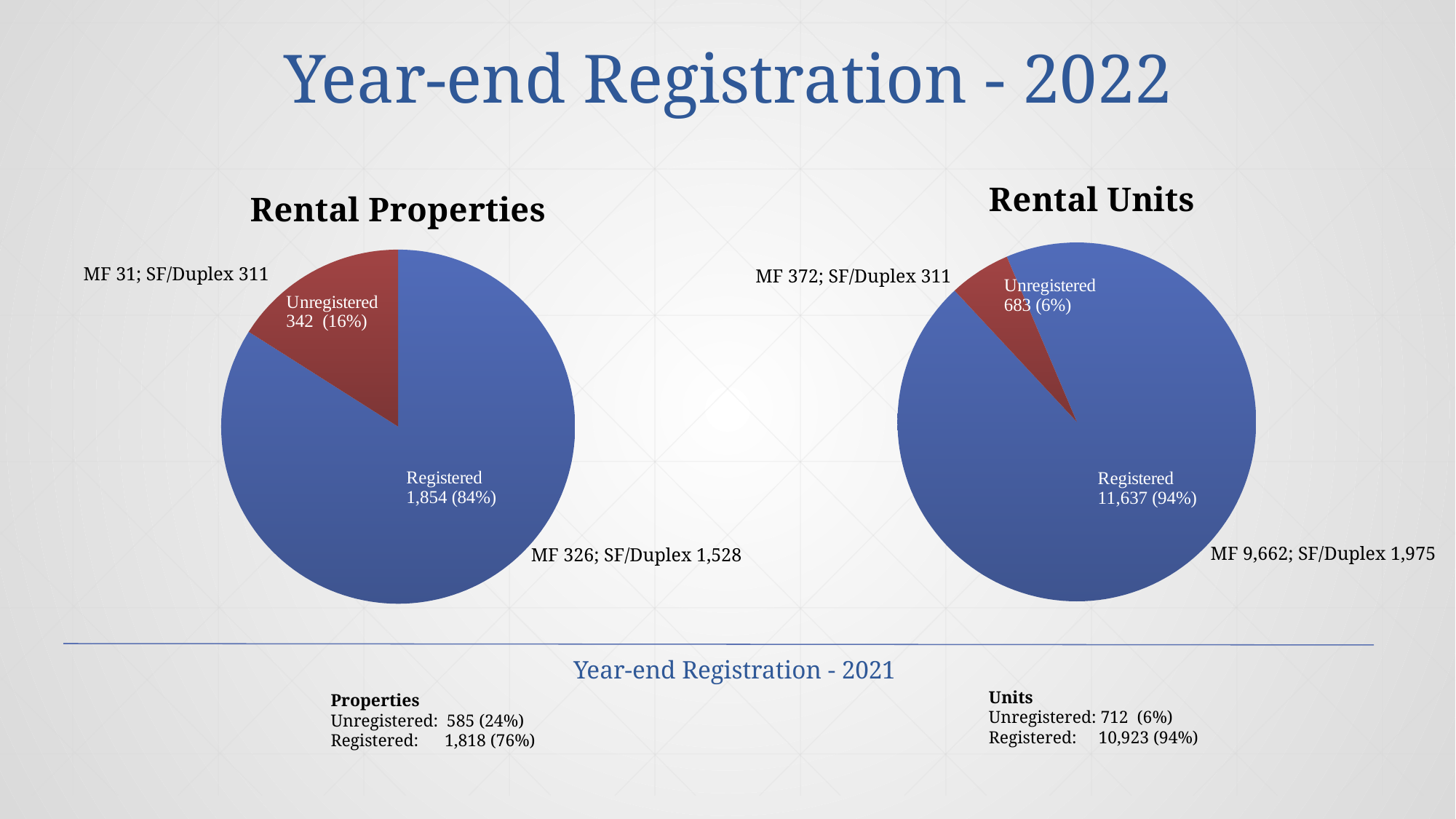
In the Rental Units chart, what is the difference between Registered and Unregistered units? 10,954 In the Rental Properties chart, how many properties are Registered? 1,854 What kind of chart is the Rental Units chart? Pie chart In the Rental Units chart, what share of the pie is Registered? 94% In the Rental Properties chart, how many properties are Unregistered? 342 In the Rental Units chart, how many units are Unregistered? 683 In the Rental Units chart, how many units are Registered? 11,637 In the Rental Properties chart, what share of the pie is Unregistered? 16% In the Rental Units chart, which slice is the smallest? Unregistered In the Rental Properties chart, which slice is the largest? Registered In the Rental Properties chart, what is the difference between Registered and Unregistered properties? 1,512 In the Rental Properties chart, how many slices does the pie have? 2